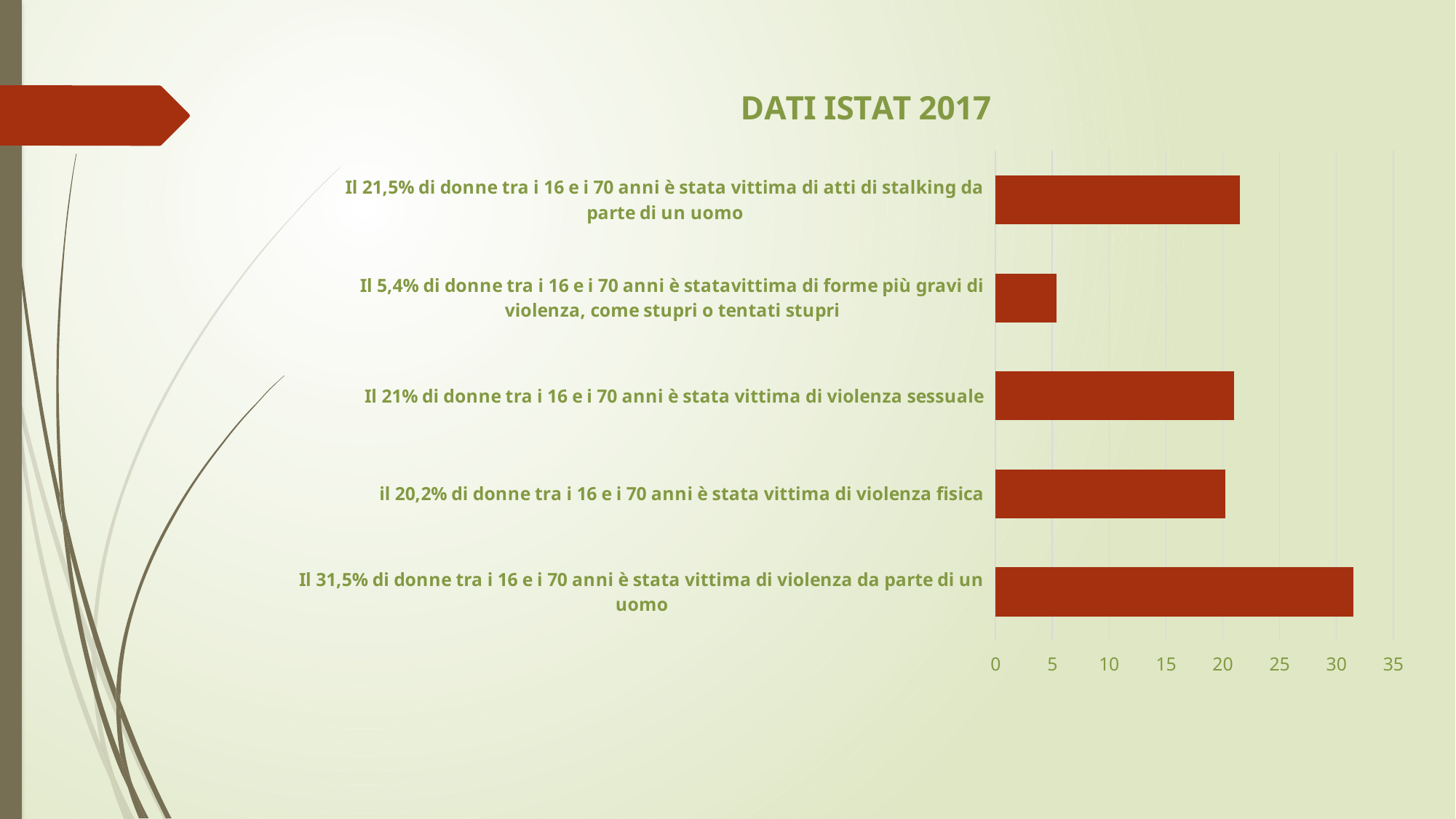
What percentage of women aged 16 to 70 has been a victim of stalking by a man according to the chart? 21,5% What kind of chart is shown on the slide? bar chart Which is larger: the value for violence by a man (31,5%) or the value for physical violence (20,2%)? violence by a man (31,5%) What is the title of the chart? DATI ISTAT 2017 Which category has the shortest bar? Il 5,4% di donne tra i 16 e i 70 anni è statavittima di forme più gravi di violenza, come stupri o tentati stupri What percentage of women aged 16 to 70 has been a victim of physical violence (violenza fisica) according to the chart? 20,2% Is the bar for violence by a man (violenza da parte di un uomo) greater or less than 30? greater What is the highest value shown on the horizontal axis? 35 What is the difference between the value for violence by a man (31,5%) and the value for rape or attempted rape (5,4%)? 26,1 How many categories (bars) does the chart show? 5 Is the bar for more serious forms of violence such as rape or attempted rape (stupri o tentati stupri) greater or less than 10? less Which category has the longest bar? Il 31,5% di donne tra i 16 e i 70 anni è stata vittima di violenza da parte di un uomo